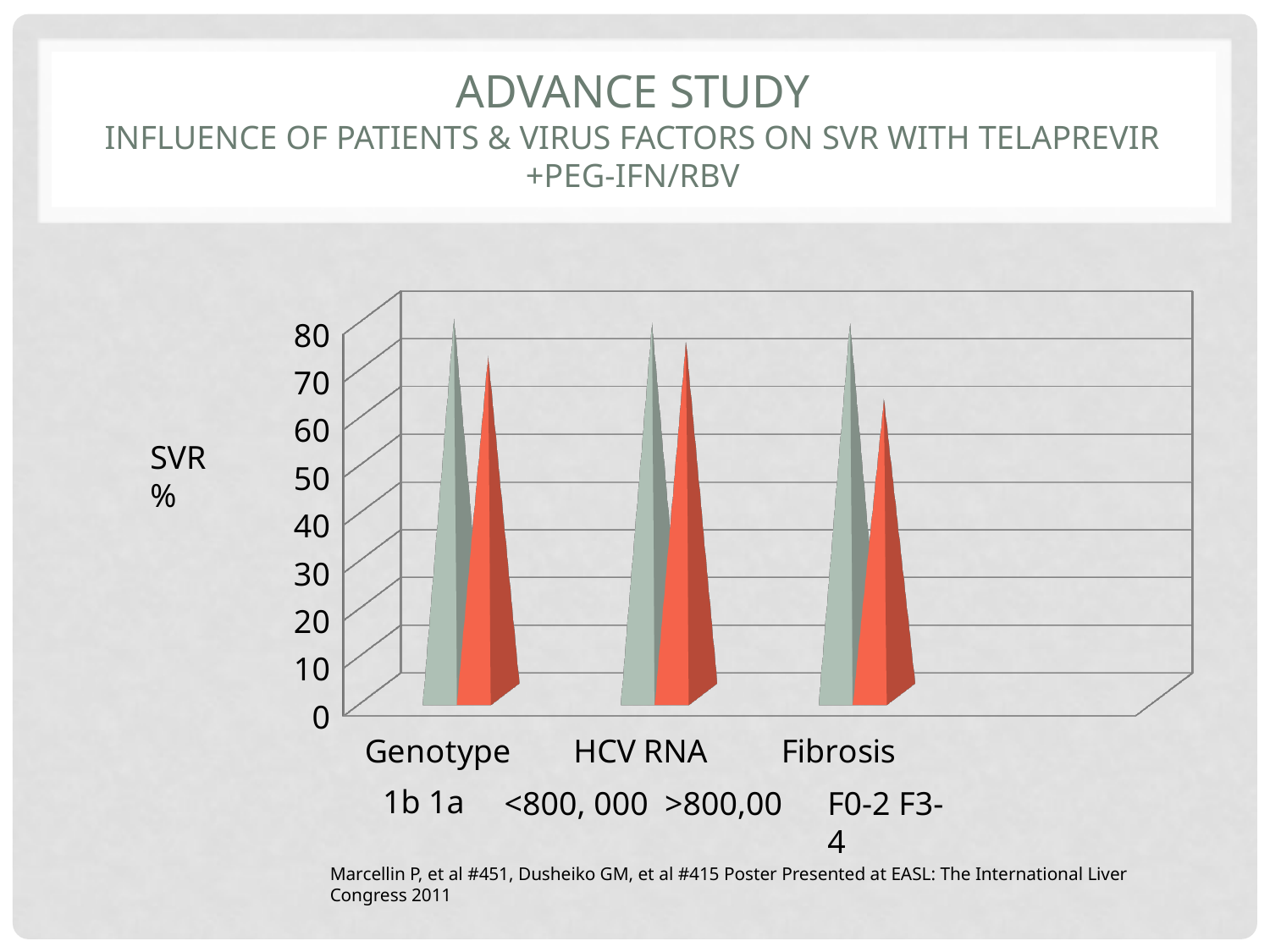
What are the three category labels along the x axis of the chart? Genotype, HCV RNA, Fibrosis Is the value of the red bar for Genotype (1a) greater or less than 60? greater Is the value of the grey bar for Fibrosis (F0-2) greater or less than 70? greater Is the value of the grey bar for Genotype (1b) greater or less than 70? greater In the Fibrosis category, which bar is larger, the grey bar (F0-2) or the red bar (F3-4)? the grey bar (F0-2) What kind of chart is shown on the slide? bar chart How many categories are shown along the x axis of the chart? 3 What is the label on the vertical axis of the chart? SVR % In the Genotype category, which bar is larger, the grey bar (1b) or the red bar (1a)? the grey bar (1b) Among the red bars, which category has the lowest value? Fibrosis